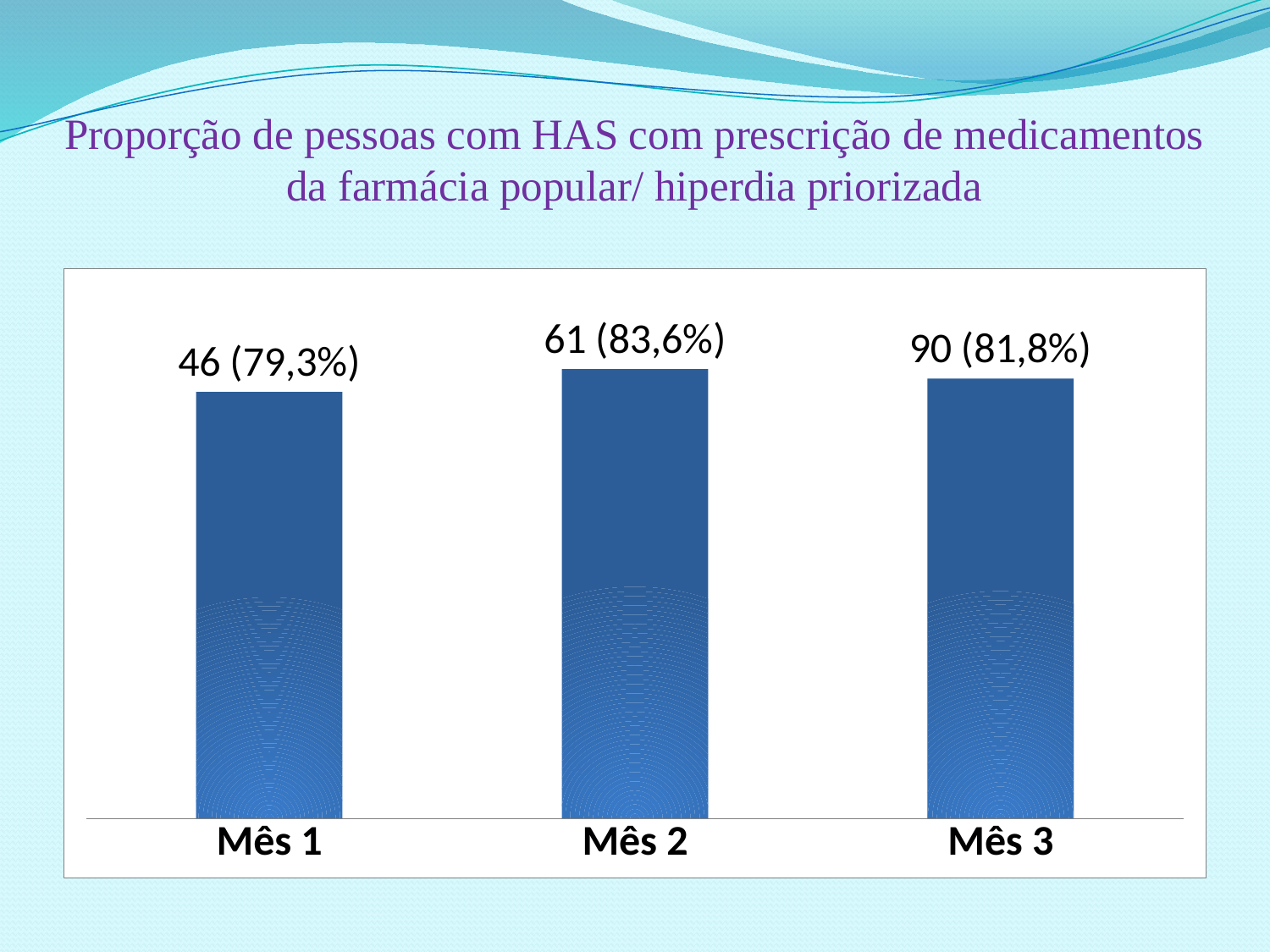
How many months (categories) are shown on the chart? 3 What is the data label shown for Mês 1? 46 (79,3%) What is the data label shown for Mês 2? 61 (83,6%) Which has the higher percentage, Mês 2 or Mês 3? Mês 2 What is the data label shown for Mês 3? 90 (81,8%) What kind of chart is shown on the slide? Bar chart Which month has the tallest bar? Mês 2 Does the percentage rise or fall from Mês 2 to Mês 3? Fall What percentage is shown for Mês 3? 81,8% What is the difference in percentage points between Mês 2 (83,6%) and Mês 1 (79,3%)? 4,3 Which month has the shortest bar? Mês 1 How many more people are counted in Mês 3 (90) than in Mês 1 (46)? 44